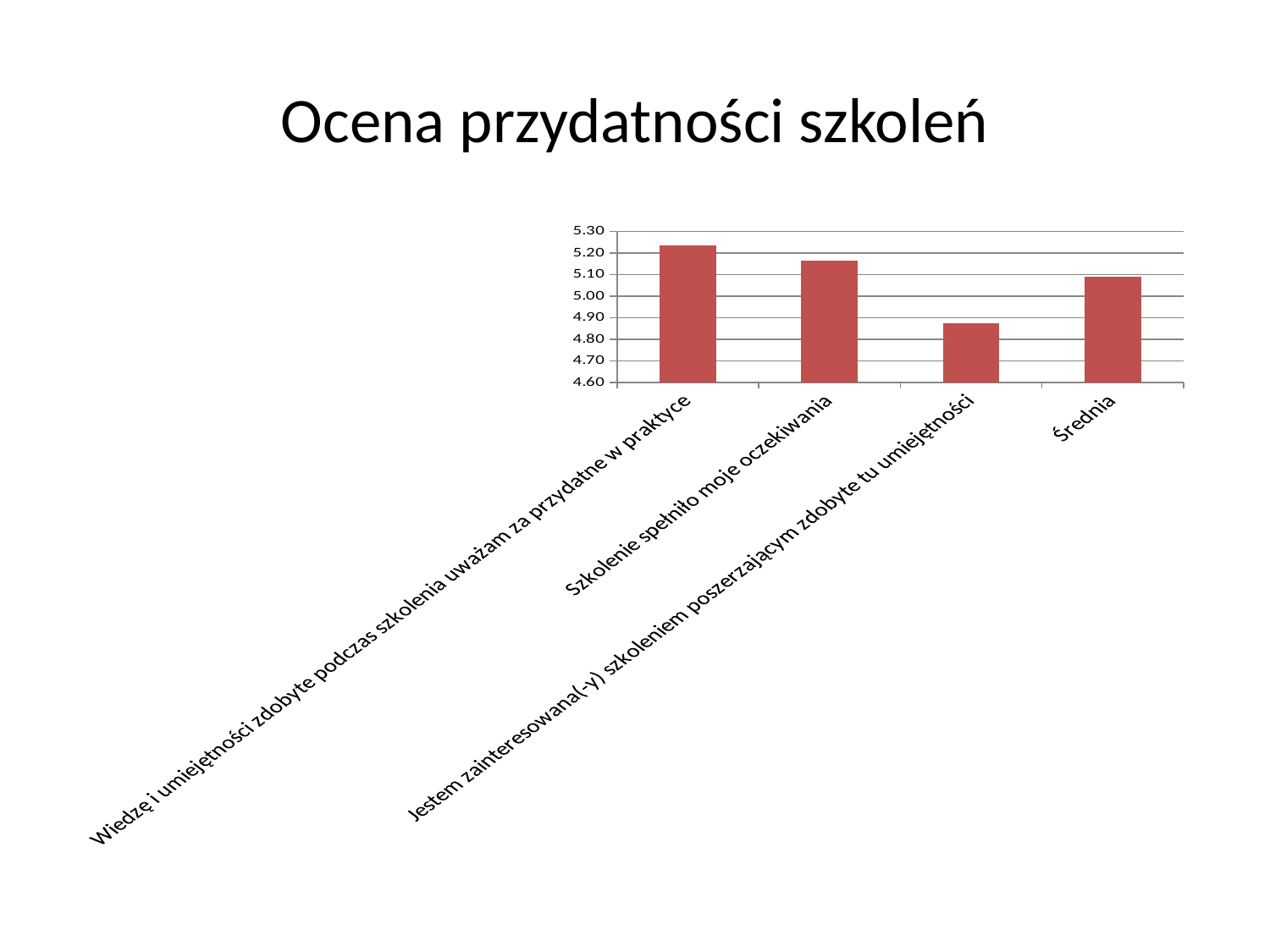
What is the title of the slide containing the chart? Ocena przydatności szkoleń Is the value for "Wiedzę i umiejętności zdobyte podczas szkolenia uważam za przydatne w praktyce" greater or less than 5.10? greater Which is larger: the value for "Szkolenie spełniło moje oczekiwania" or the value for "Średnia"? Szkolenie spełniło moje oczekiwania Which is larger: the value for "Średnia" or the value for "Jestem zainteresowana(-y) szkoleniem poszerzającym zdobyte tu umiejętności"? Średnia How many categories are shown on the x axis of the chart? 4 Is the value for "Szkolenie spełniło moje oczekiwania" greater or less than 5.10? greater Is the value for "Jestem zainteresowana(-y) szkoleniem poszerzającym zdobyte tu umiejętności" greater or less than 5.00? less What is the lowest value shown on the vertical axis of the chart? 4.60 Which category has the lowest bar in the chart? Jestem zainteresowana(-y) szkoleniem poszerzającym zdobyte tu umiejętności What type of chart is shown on the slide? bar chart Which category has the highest bar in the chart? Wiedzę i umiejętności zdobyte podczas szkolenia uważam za przydatne w praktyce